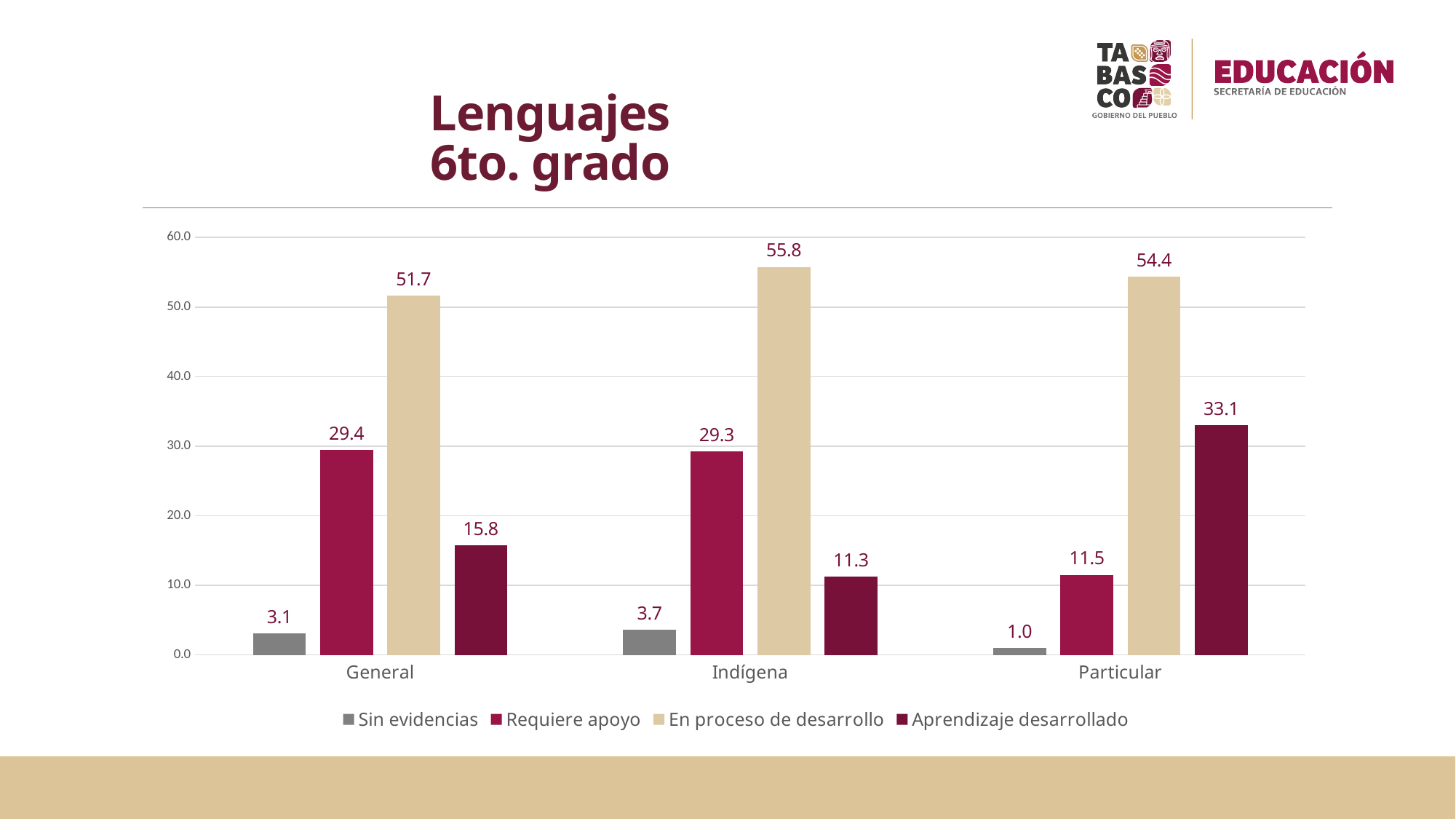
How many categories are shown on the x axis? 3 What kind of chart is shown on the slide? Bar chart Which is larger: "En proceso de desarrollo" in General or in Particular? Particular Which category has the highest value for "Aprendizaje desarrollado"? Particular Which series is shown in grey in the legend? Sin evidencias How many series does the legend list? 4 What is the title of the slide? Lenguajes 6to. grado What is the value for "Aprendizaje desarrollado" in the General category? 15.8 What is the value for "Sin evidencias" in the Particular category? 1.0 What is the value for "En proceso de desarrollo" in the Indígena category? 55.8 What is the difference between "Requiere apoyo" in General and "Requiere apoyo" in Particular? 17.9 Which category has the lowest value for "Sin evidencias"? Particular